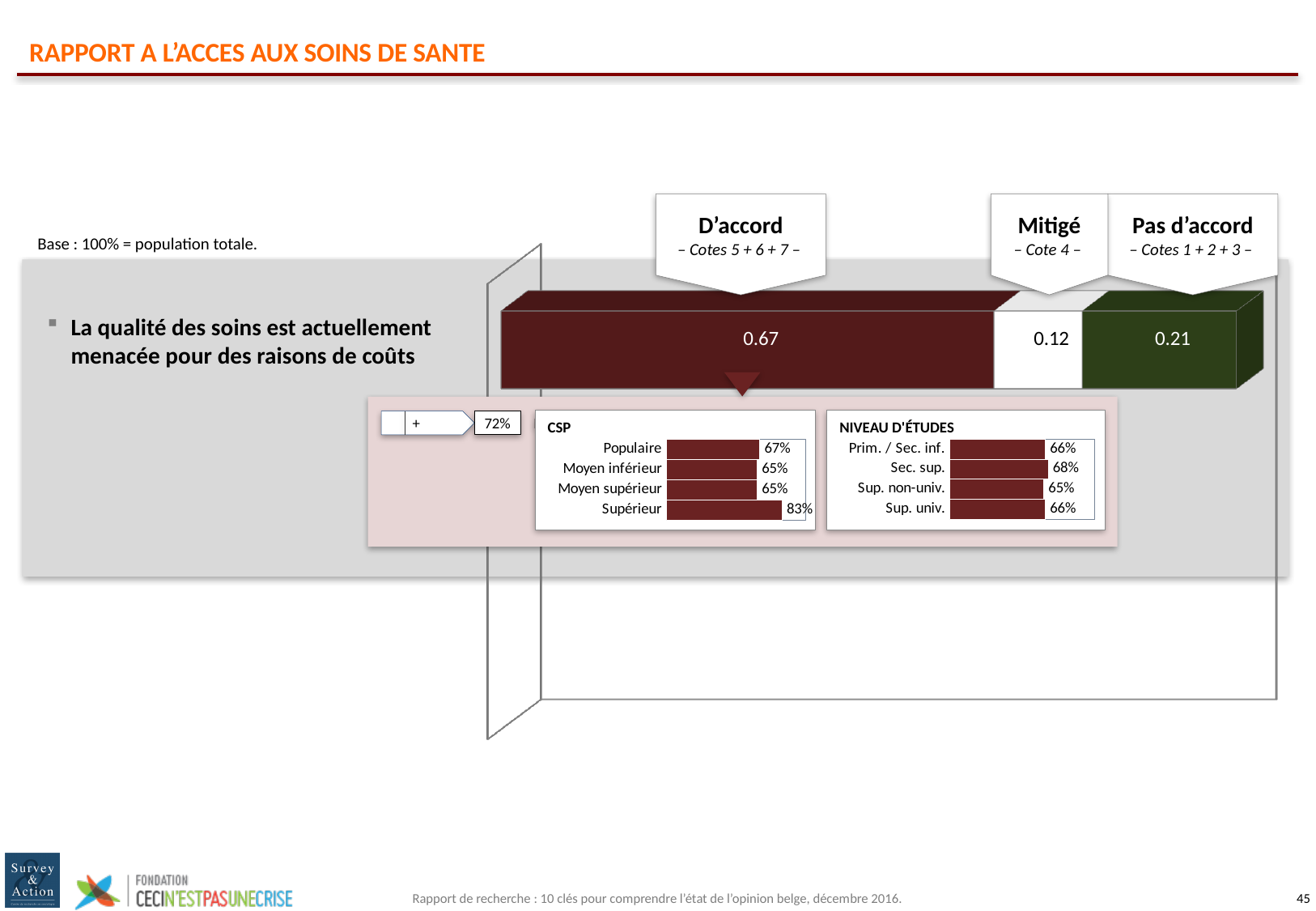
What kind of chart is the CSP chart? Bar chart In the CSP chart, what is the difference between 'Supérieur' and 'Populaire'? 16% In the main stacked bar, what is the value for 'Pas d'accord'? 0.21 In the main stacked bar for 'La qualité des soins est actuellement menacée pour des raisons de coûts', what is the value for 'D'accord'? 0.67 In the main stacked bar, which segment is the largest? D'accord In the main stacked bar, what is the difference between 'D'accord' and 'Pas d'accord'? 0.46 In the CSP chart, which category has the highest value? Supérieur In the CSP chart, what is the value for 'Supérieur'? 83% In the main stacked bar, how many segments are there? 3 In the NIVEAU D'ÉTUDES chart, what is the value for 'Sec. sup.'? 68% In the main stacked bar, what is the value for 'Mitigé'? 0.12 In the NIVEAU D'ÉTUDES chart, which category has the lowest value? Sup. non-univ.